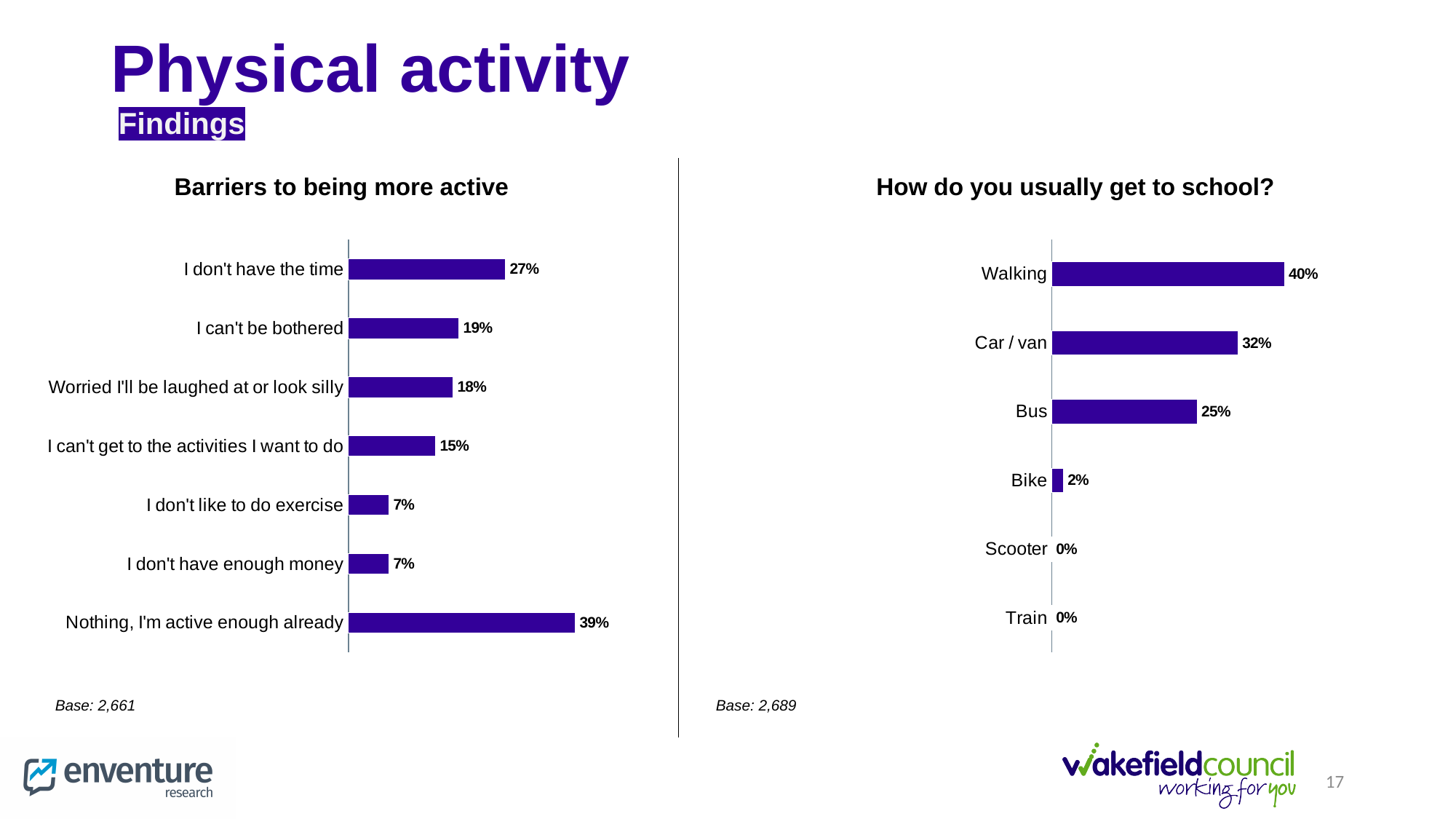
In the 'Barriers to being more active' chart, what is the difference between 'I can't be bothered' and 'I can't get to the activities I want to do'? 4% In the 'How do you usually get to school?' chart, which mode of travel has the highest percentage? Walking In the 'How do you usually get to school?' chart, how many travel modes are listed? 6 In the 'How do you usually get to school?' chart, what is the difference between Walking and Car / van? 8% What type of chart is the 'How do you usually get to school?' chart? Bar chart In the 'Barriers to being more active' chart, what percentage is shown for 'I don't have the time'? 27% In the 'How do you usually get to school?' chart, what percentage is shown for Bus? 25% In the 'Barriers to being more active' chart, how many barrier categories are shown? 7 In the 'Barriers to being more active' chart, which barrier has the highest percentage? Nothing, I'm active enough already In the 'How do you usually get to school?' chart, which is larger, Car / van or Bus? Car / van In the 'Barriers to being more active' chart, what percentage is shown for 'Worried I'll be laughed at or look silly'? 18% What is the base (number of respondents) shown under the 'Barriers to being more active' chart? 2,661